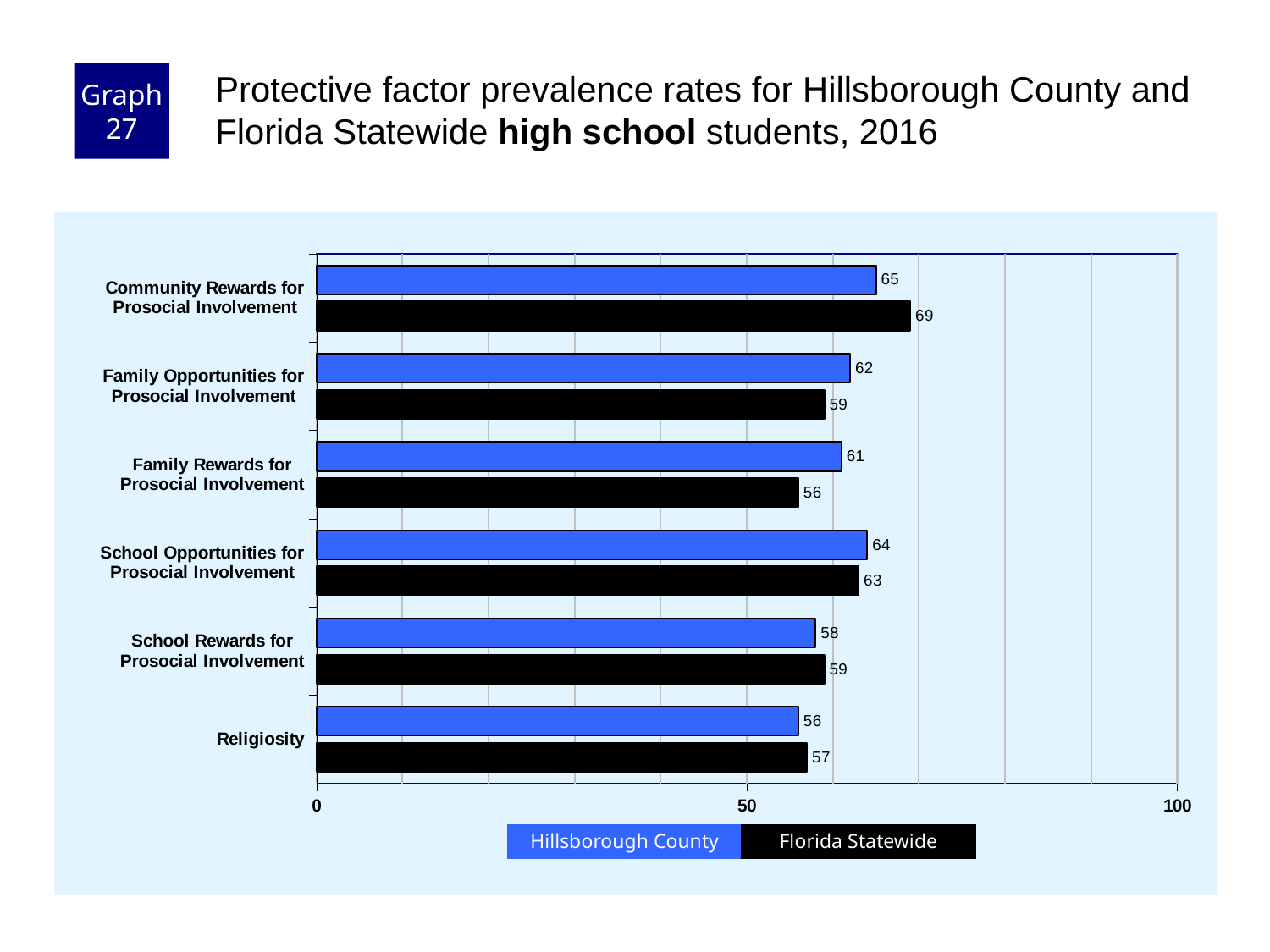
What is the Hillsborough County value for Community Rewards for Prosocial Involvement? 65 What is the difference between the Florida Statewide and Hillsborough County values for Community Rewards for Prosocial Involvement? 4 What is the Florida Statewide value for Family Rewards for Prosocial Involvement? 56 What kind of chart is shown on the slide? bar chart What is the Hillsborough County value for Religiosity? 56 Which category has the lowest Hillsborough County value? Religiosity How many series does the legend list? 2 For School Rewards for Prosocial Involvement, which is larger: Hillsborough County or Florida Statewide? Florida Statewide Which category has the highest Florida Statewide value? Community Rewards for Prosocial Involvement How many categories are shown on the chart? 6 What is the difference between the Hillsborough County and Florida Statewide values for Family Rewards for Prosocial Involvement? 5 Is the Florida Statewide value for Community Rewards for Prosocial Involvement greater or less than 50? greater